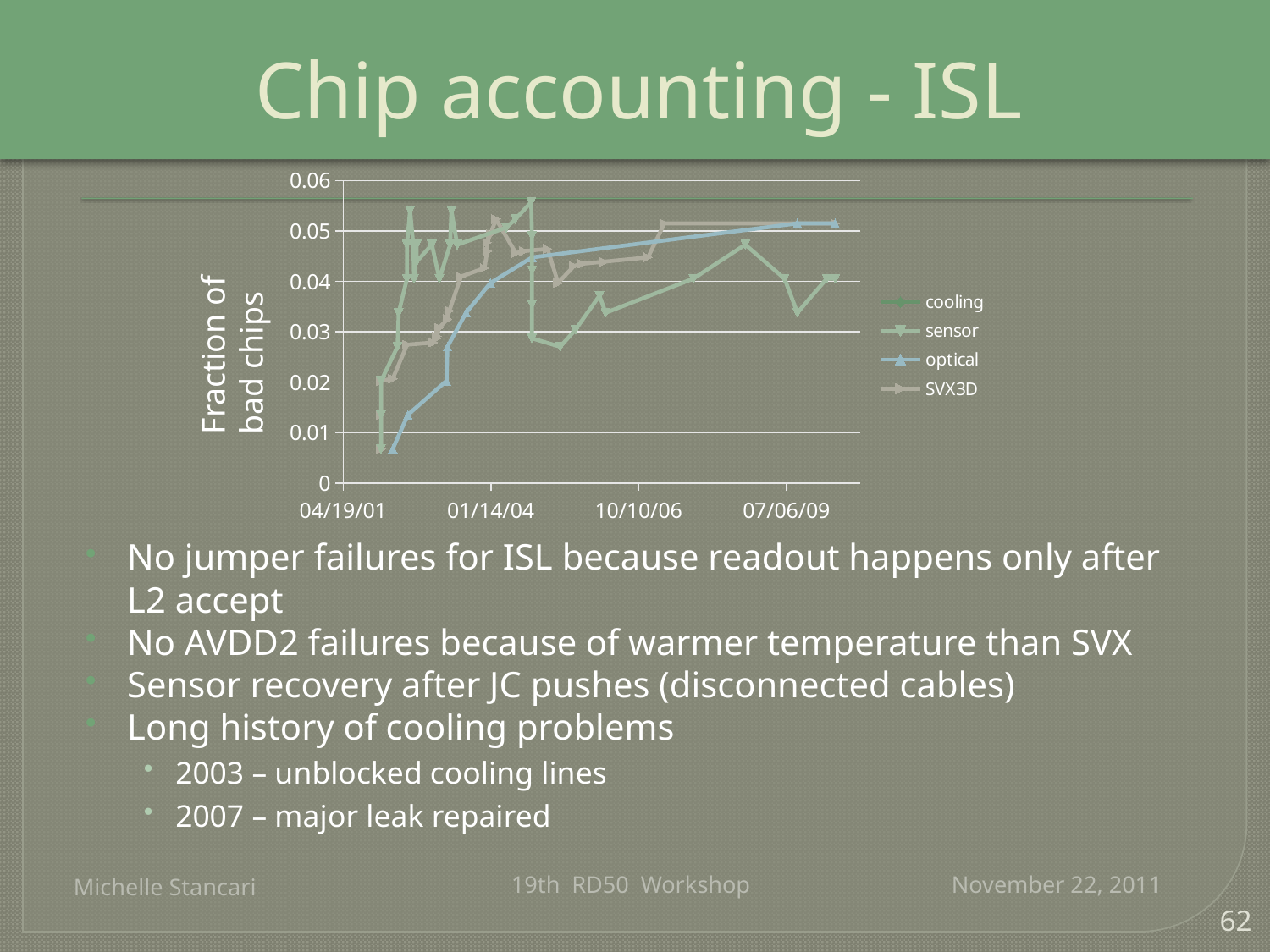
Does the optical series rise or fall over time along the x axis? rise Is the last value of the optical series greater or less than 0.04? greater What are the series names listed in the chart legend? cooling, sensor, optical, SVX3D Is the last value of the sensor series greater or less than 0.03? greater What is the first date shown on the horizontal axis of the chart? 04/19/01 What is the highest value shown on the vertical axis of the chart? 0.06 How many series does the chart legend list? 4 Is the first value of the optical series greater or less than 0.01? less What is the label of the vertical axis of the chart? Fraction of bad chips How many date labels are shown on the horizontal axis of the chart? 4 What kind of chart is shown on the slide? line chart What is the last date shown on the horizontal axis of the chart? 07/06/09